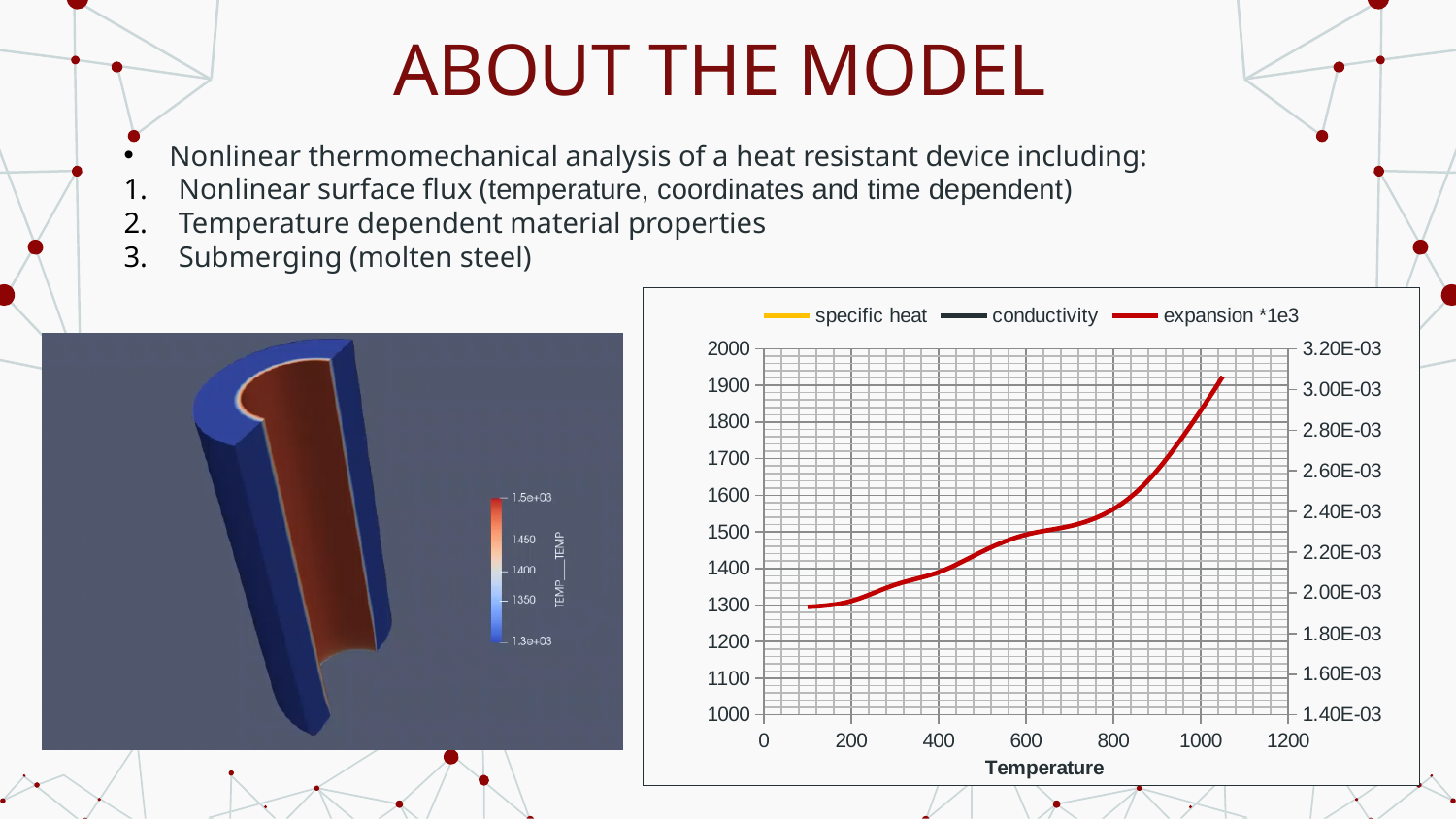
Does the red expansion *1e3 line rise or fall as Temperature increases along the x axis? rise Which legend entry is drawn in red in the chart? expansion *1e3 What is the title of the horizontal axis of the chart? Temperature How many series does the legend of the chart list? 3 What kind of chart is shown on the right side of the slide? line chart